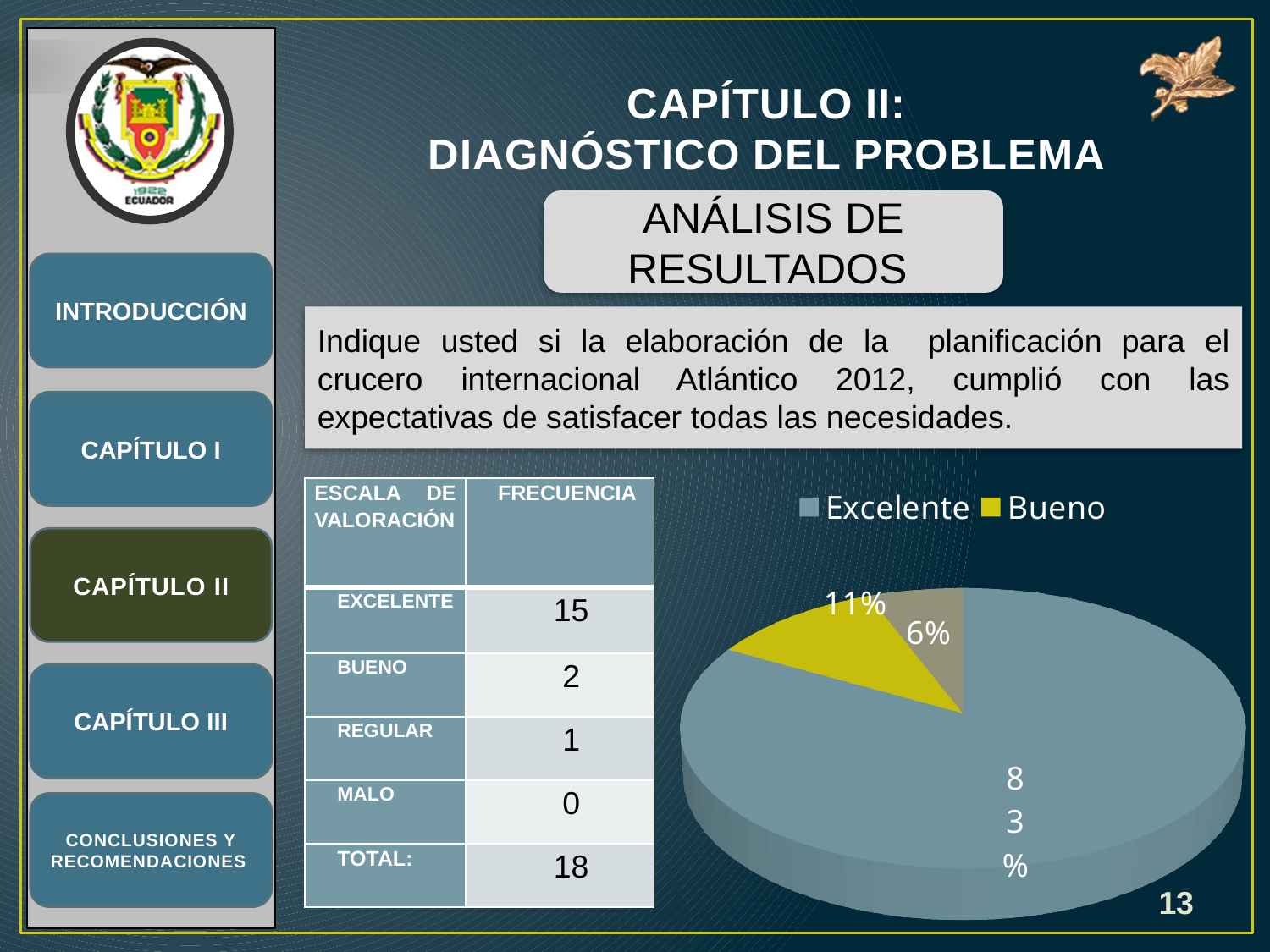
In the pie chart, what share is labelled for the Excelente slice? 83% What kind of chart is shown on the right of the slide? pie chart How many entries does the pie chart's legend list? 2 What colour represents Bueno in the pie chart's legend? yellow Which slice of the pie chart is the largest? Excelente In the pie chart, what percentage is labelled on the small grey slice? 6% In the pie chart, which is larger, the Excelente slice or the Bueno slice? Excelente Which slice of the pie chart is the smallest? the grey slice (6%) How many slices does the pie chart have? 3 In the pie chart, what share is labelled for the Bueno slice? 11% In the pie chart, what is the difference in percentage points between the Excelente slice (83%) and the Bueno slice (11%)? 72% Is the share of the Excelente slice in the pie chart greater or less than 50%? greater